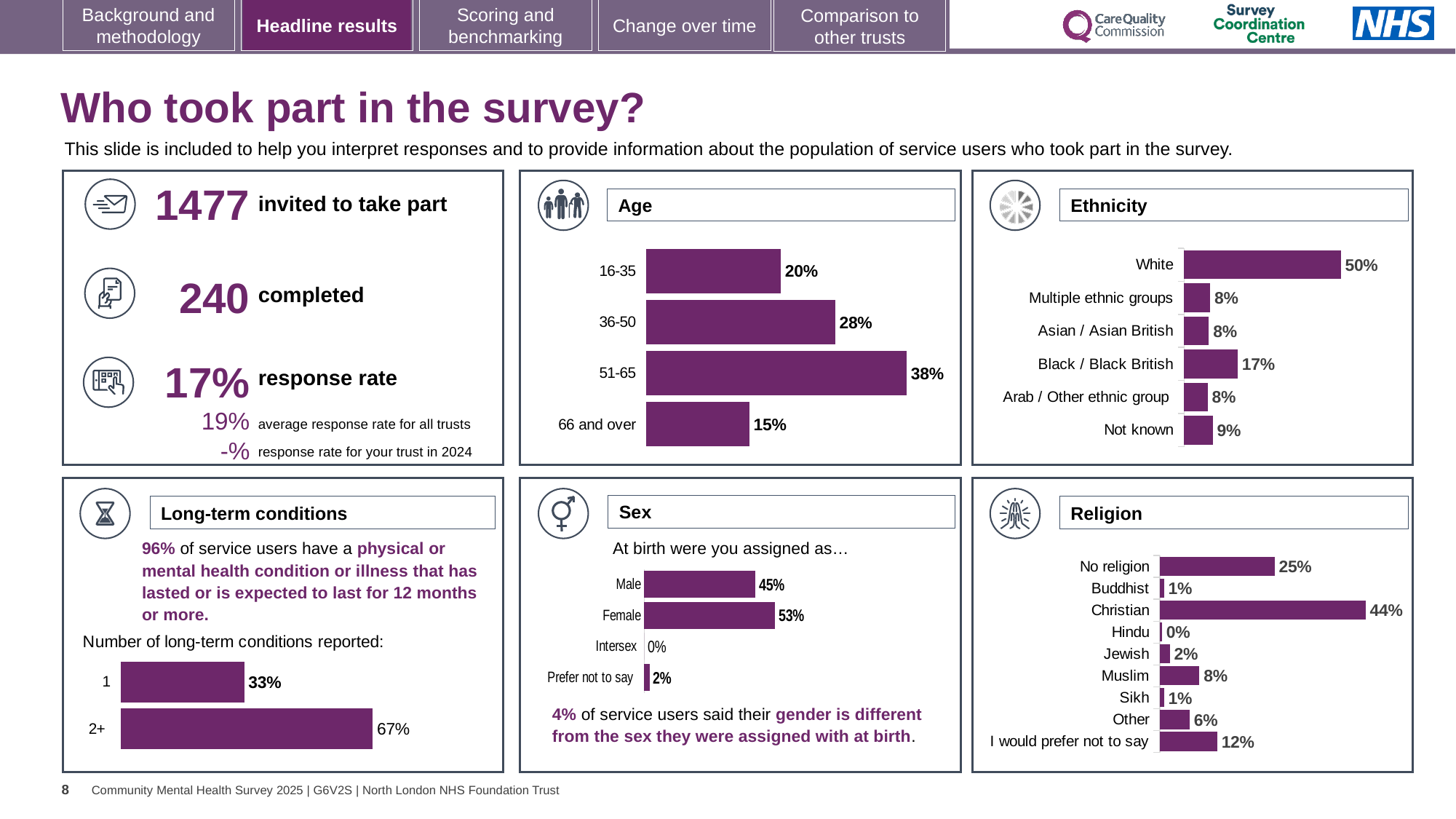
In the Age chart, what percentage of respondents were aged 51-65? 38% In the Long-term conditions chart, what percentage reported 2+ long-term conditions? 67% What type of chart is used in the Age panel? Bar chart In the Religion chart, what is the difference between the Christian and No religion percentages? 19% In the Ethnicity chart, which category has the highest percentage? White In the Sex chart, what percentage of respondents were assigned Female at birth? 53% In the Ethnicity chart, how many categories are shown? 6 In the Religion chart, what is the value for I would prefer not to say? 12% In the Religion chart, which is larger, Muslim or Other? Muslim In the Age chart, which age group has the lowest percentage? 66 and over In the Sex chart, how many categories are shown? 4 In the Ethnicity chart, what is the value for Black / Black British? 17%